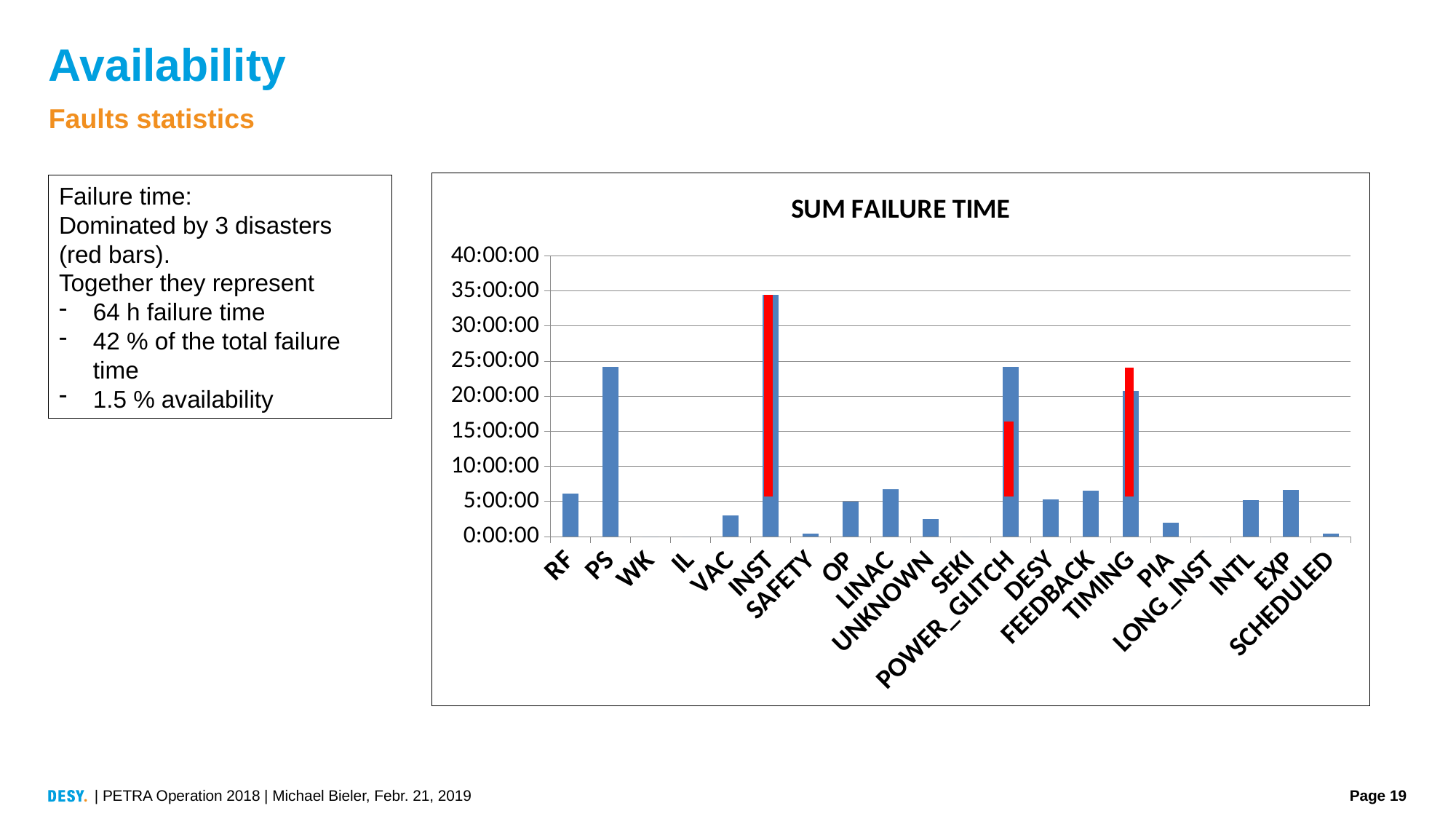
What kind of chart is shown on the slide? bar chart Is the value for RF greater or less than 10:00:00? less Is the value for TIMING greater or less than 15:00:00? greater Is the value for LINAC greater or less than 10:00:00? less Which has a larger sum failure time, PS or RF? PS Which category has the highest sum failure time? INST Which has a larger sum failure time, INST or POWER_GLITCH? INST How many categories are shown on the x axis of the chart? 20 What is the title of the chart? SUM FAILURE TIME Which three categories contain red bar segments? INST, POWER_GLITCH, TIMING